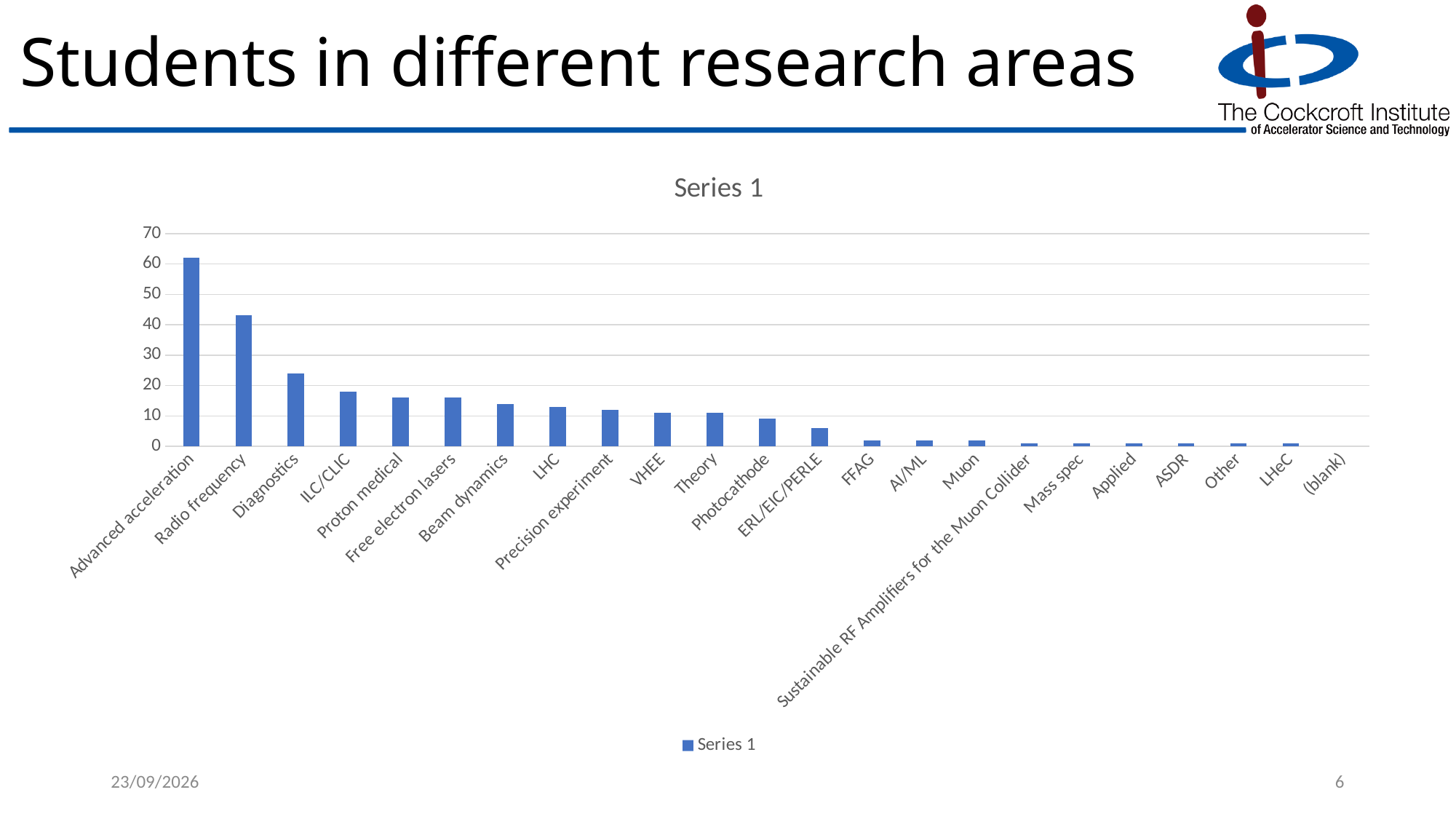
Is the value for Radio frequency greater or less than 30? greater Is the value for Diagnostics greater or less than 20? greater What kind of chart is shown on the slide? bar chart Which has more students, Advanced acceleration or Radio frequency? Advanced acceleration How many series does the legend list? 1 Is the value for ILC/CLIC greater or less than 20? less How many research area categories are shown on the x axis? 23 Do the values rise or fall moving from left to right along the x axis? fall Which research area has the highest number of students? Advanced acceleration Which has more students, LHC or Photocathode? LHC